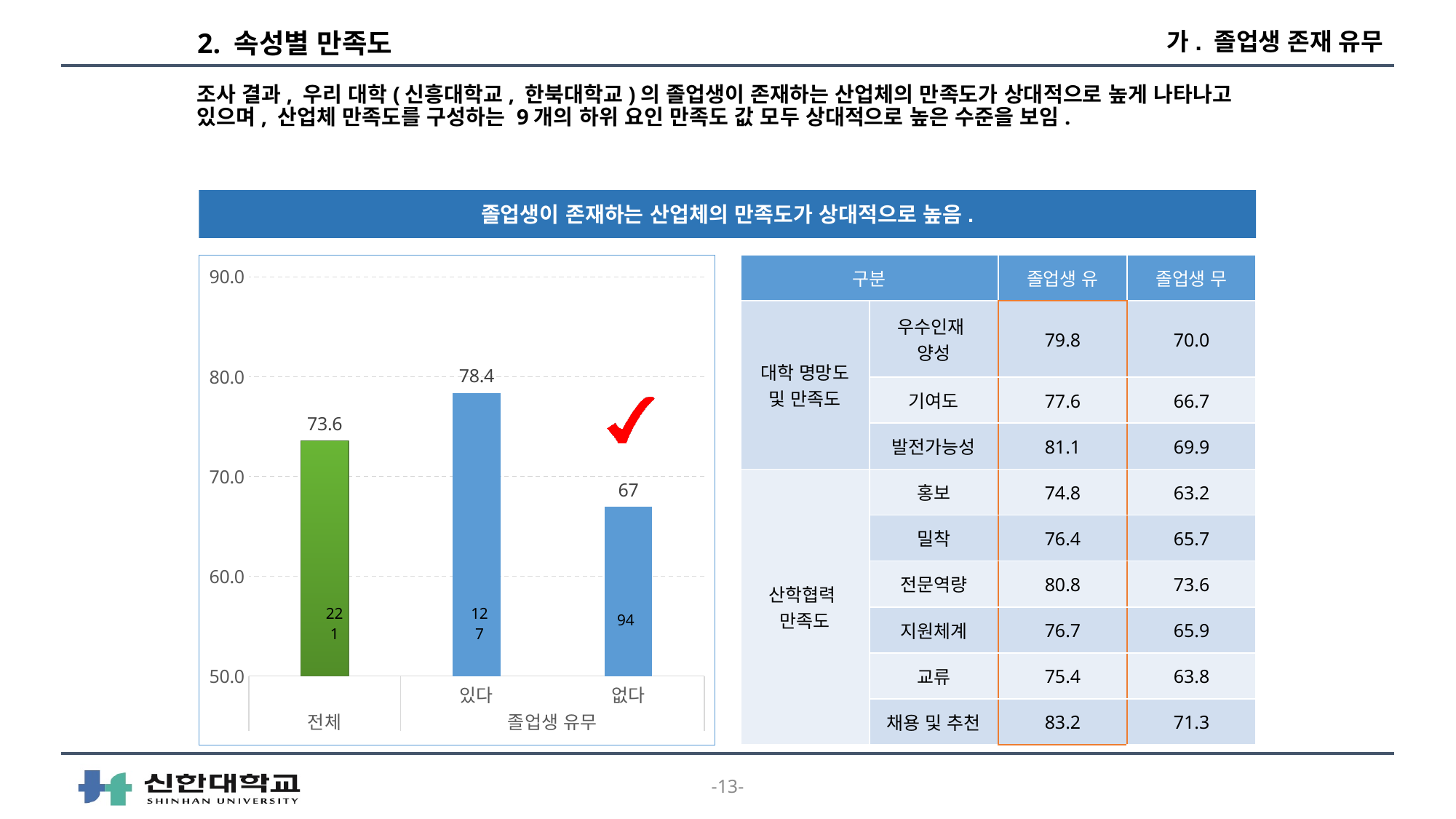
What number is printed inside the 없다 bar? 94 Which bar has the highest value? 있다 How many bars are plotted in the chart? 3 Which is larger, the value for 전체 or the value for 없다? 전체 What is the satisfaction value for the 없다 bar? 67 Is the value for 없다 greater or less than 70.0? less What kind of chart is shown on the slide? bar chart What is the satisfaction value for the 있다 bar? 78.4 What is the satisfaction value for the 전체 bar? 73.6 What is the difference between the 있다 and 전체 values? 4.8 Which bar has the lowest value? 없다 What is the difference between the 있다 and 없다 values? 11.4